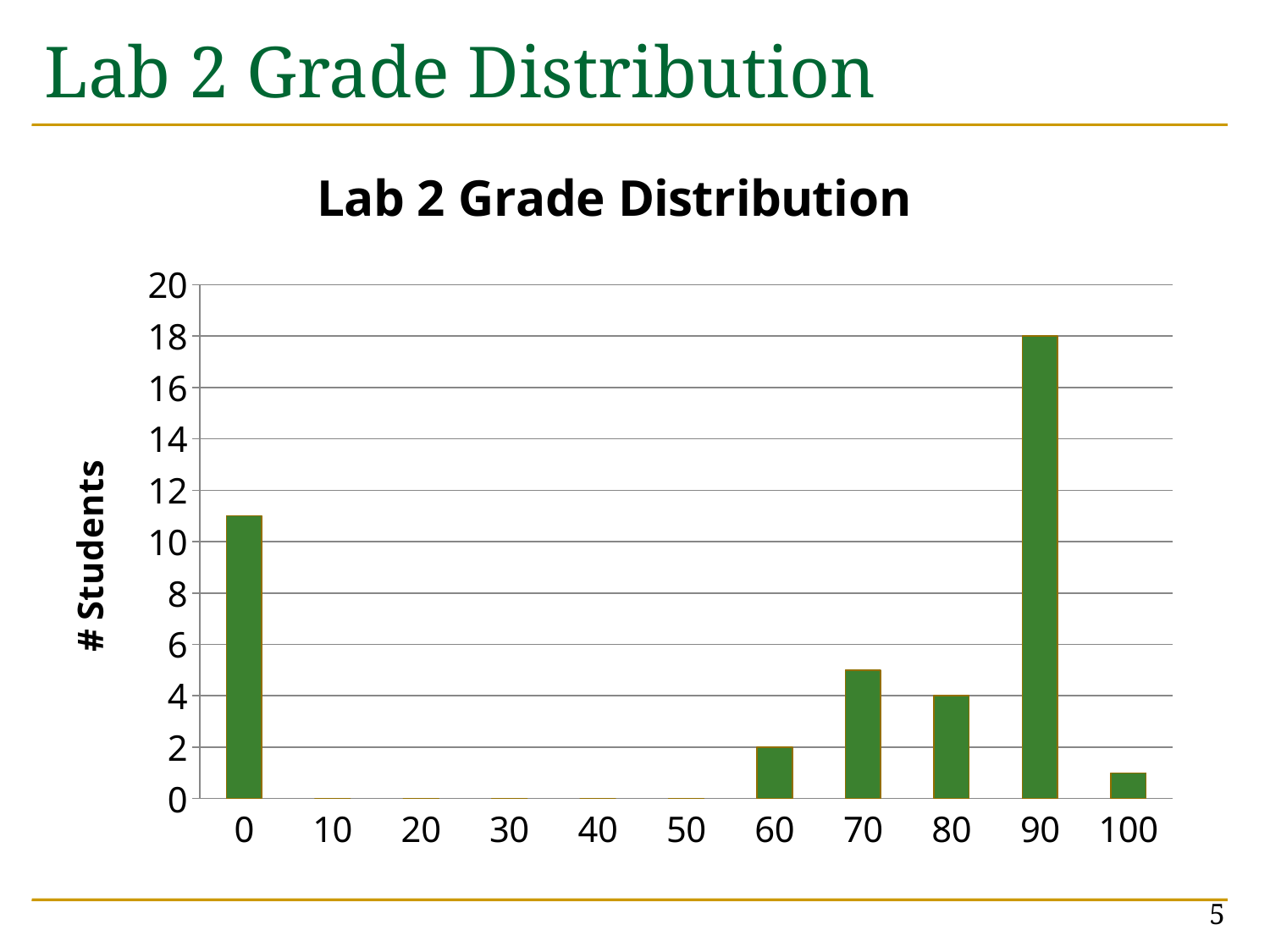
What kind of chart is shown on the slide? bar chart Which grade category has the highest number of students? 90 How many students are in the 90 grade category? 18 What is the label on the vertical axis? # Students Which has more students, the 0 grade category or the 70 grade category? 0 How many grade categories are shown on the x axis? 11 Is the number of students in the 100 grade category greater or less than 2? less What is the title of the chart? Lab 2 Grade Distribution Is the number of students in the 0 grade category greater or less than 10? greater How many students are in the 80 grade category? 4 How many students are in the 60 grade category? 2 What is the difference in number of students between the 90 and 80 grade categories? 14